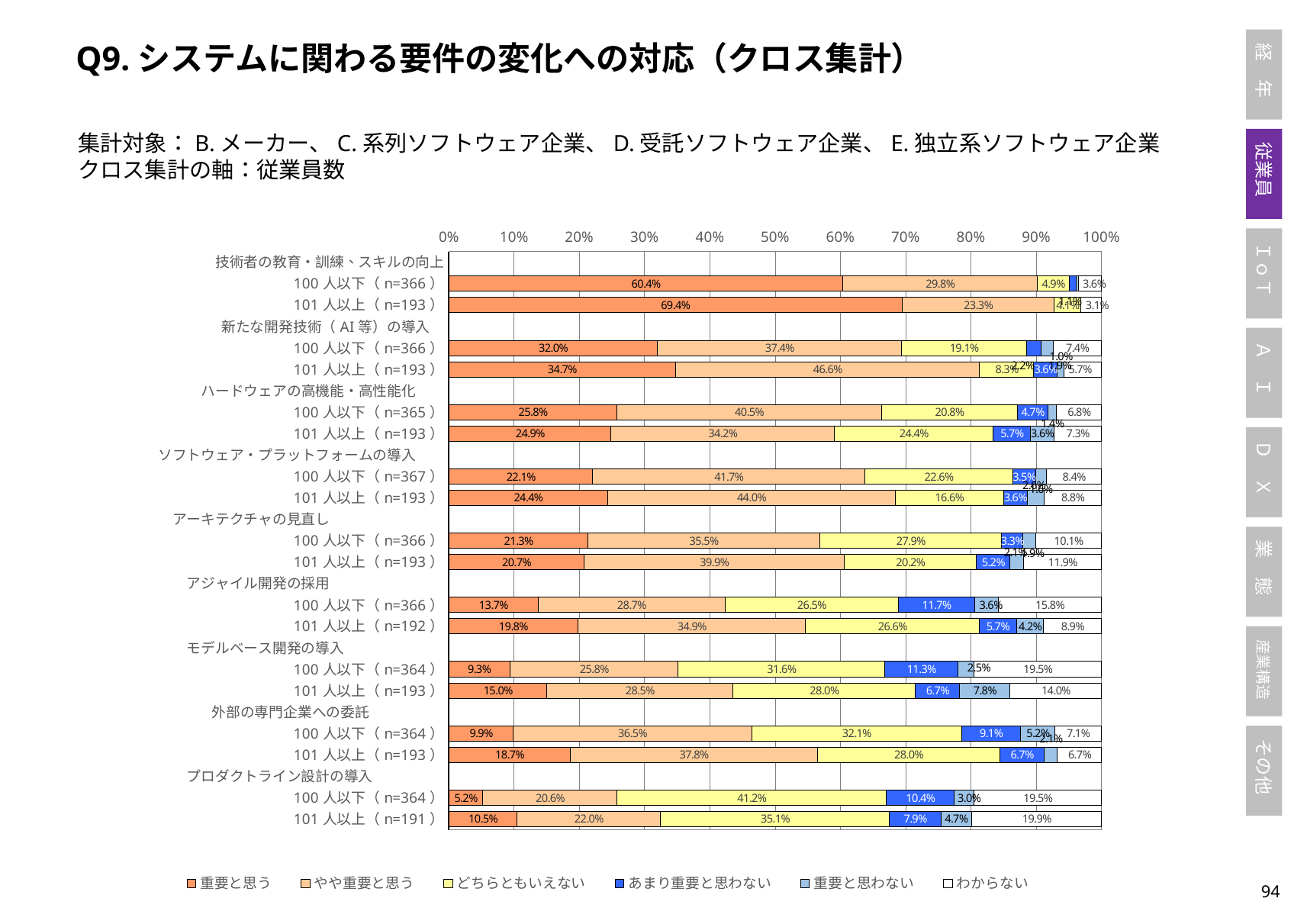
What percentage of respondents from companies with 100 or fewer employees (n=366) answered 重要と思う for 技術者の教育・訓練、スキルの向上? 60.4% Which legend entry is shown in yellow? どちらともいえない What kind of chart is shown on the slide? Stacked bar chart What is the difference in the 重要と思う share for 技術者の教育・訓練、スキルの向上 between companies with 101 or more employees and those with 100 or fewer employees? 9.0% What is the やや重要と思う share for 新たな開発技術（AI等）の導入 among companies with 101 or more employees (n=193)? 46.6% How many series does the legend list? 6 Which bar has the highest 重要と思う share? 技術者の教育・訓練、スキルの向上 101人以上（n=193） For アジャイル開発の採用, which group has the larger 重要と思う share: 100人以下 (n=366) or 101人以上 (n=192)? 101人以上（n=192） What percentage of respondents from companies with 101 or more employees (n=193) answered 重要と思う for 技術者の教育・訓練、スキルの向上? 69.4% What is the わからない share for モデルベース開発の導入 among companies with 100 or fewer employees (n=364)? 19.5% How many topic categories (excluding the employee-size sub-rows) are shown on the chart? 9 Which bar has the lowest 重要と思う share? プロダクトライン設計の導入 100人以下（n=364）